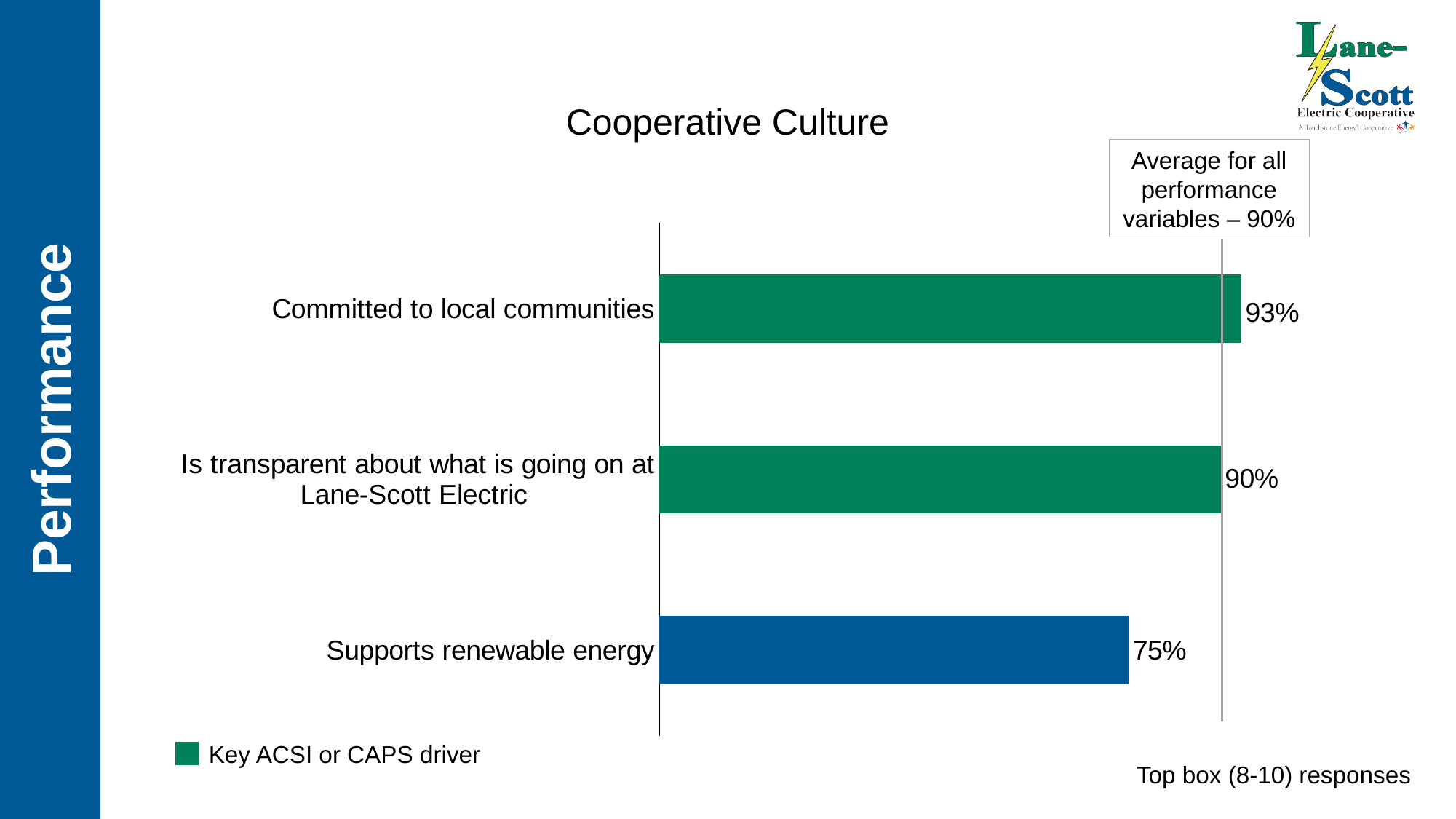
How many categories are shown in the chart? 3 Which is larger, the value for "Committed to local communities" or the value for "Supports renewable energy"? Committed to local communities What is the average for all performance variables shown by the vertical reference line? 90% Which category has the highest value? Committed to local communities What is the difference between the values for "Committed to local communities" and "Supports renewable energy"? 18% What kind of chart is shown on the slide? Bar chart What is the difference between the values for "Is transparent about what is going on at Lane-Scott Electric" and "Supports renewable energy"? 15% What is the value for "Committed to local communities"? 93% What is the value for "Supports renewable energy"? 75% What is the title of the chart? Cooperative Culture What is the value for "Is transparent about what is going on at Lane-Scott Electric"? 90% Which category has the lowest value? Supports renewable energy